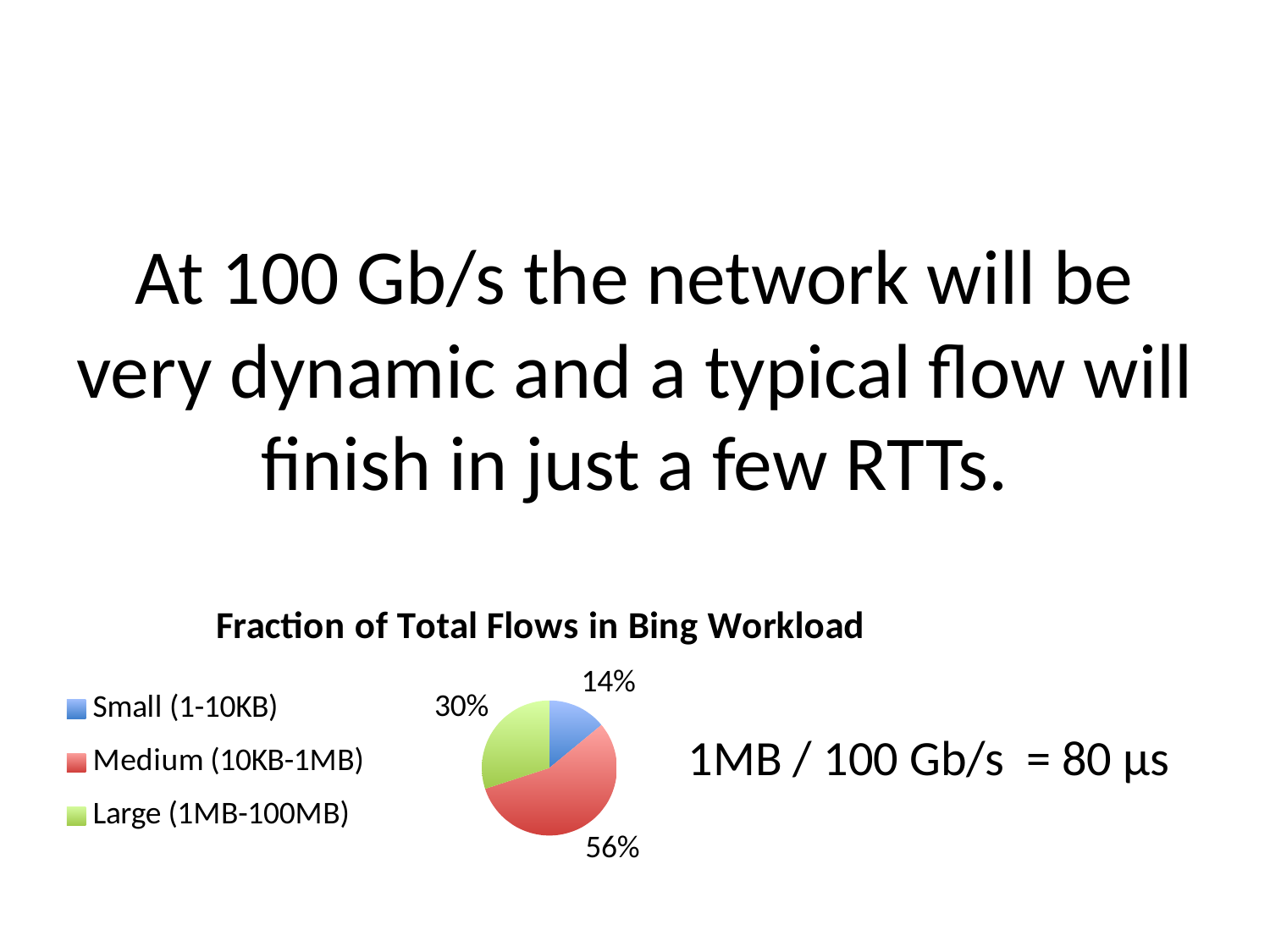
What colour is the slice for Medium (10KB-1MB)? red What share of total flows is Small (1-10KB)? 14% How many categories does the pie chart have? 3 What is the difference in percentage points between the Large (1MB-100MB) and Small (1-10KB) shares? 16 What is the difference in percentage points between the Medium (10KB-1MB) and Large (1MB-100MB) shares? 26 Which is larger, the share for Large (1MB-100MB) or the share for Small (1-10KB)? Large (1MB-100MB) Which category has the smallest share of the pie? Small (1-10KB) Which category has the largest share of the pie? Medium (10KB-1MB) What share of total flows is Medium (10KB-1MB)? 56% What kind of chart is shown on the slide? pie chart What share of total flows is Large (1MB-100MB)? 30% What is the title of the chart? Fraction of Total Flows in Bing Workload